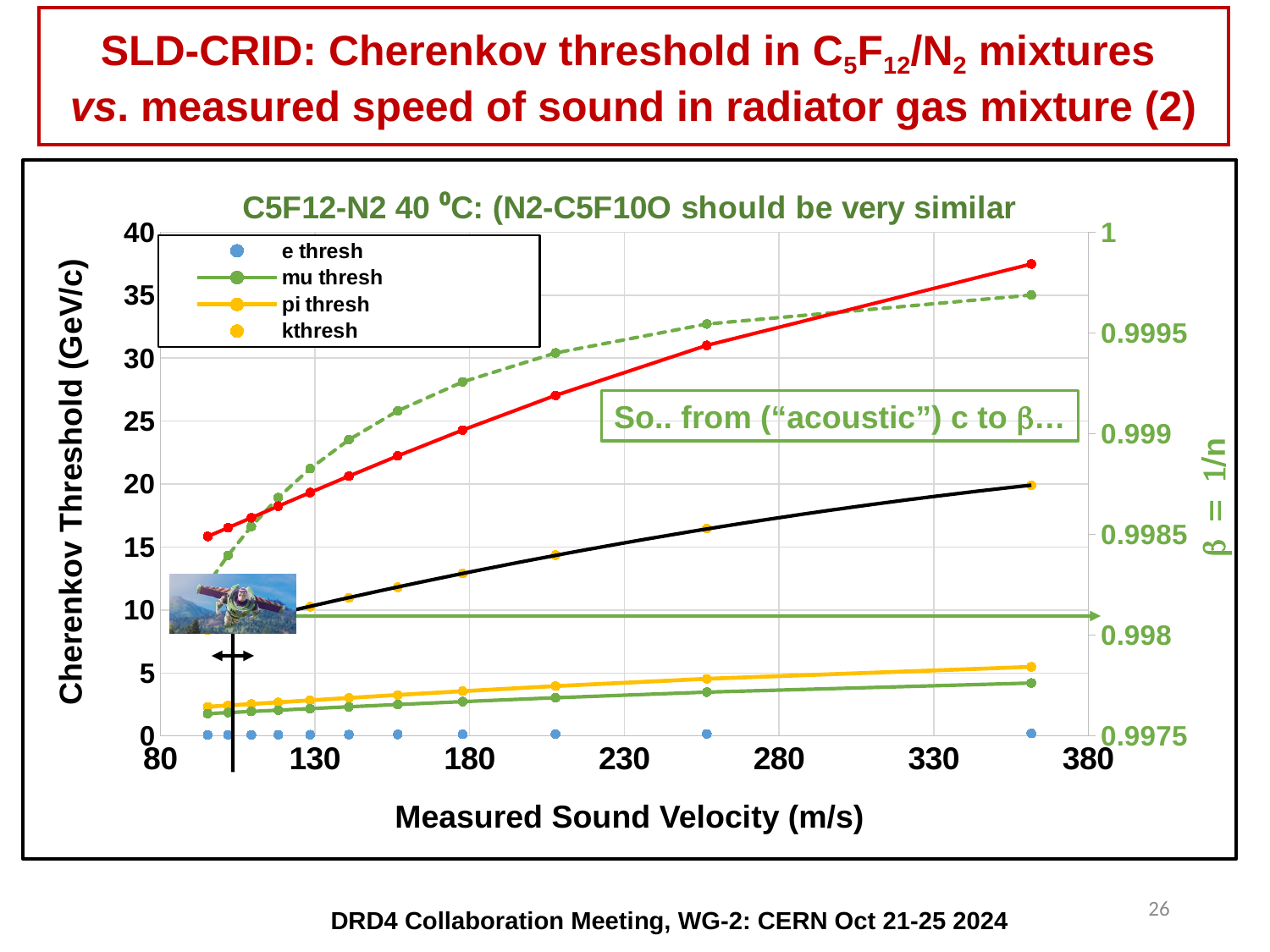
How many series does the legend list? 4 What kind of chart is shown on the slide? line chart Is the value of the red line at the highest sound velocity (about 360 m/s) greater or less than 35? greater At a sound velocity of about 360 m/s, which is larger: the red line or the black line? the red line Is the value of the red line at its lowest sound velocity (just below 100 m/s) greater or less than 20? less Does the red line rise or fall as the measured sound velocity increases? rise Is the e thresh value at a sound velocity of about 180 m/s greater or less than 5? less What is the title of the left y axis? Cherenkov Threshold (GeV/c) At a sound velocity of about 360 m/s, which is larger: pi thresh or mu thresh? pi thresh What is the title of the x axis? Measured Sound Velocity (m/s)